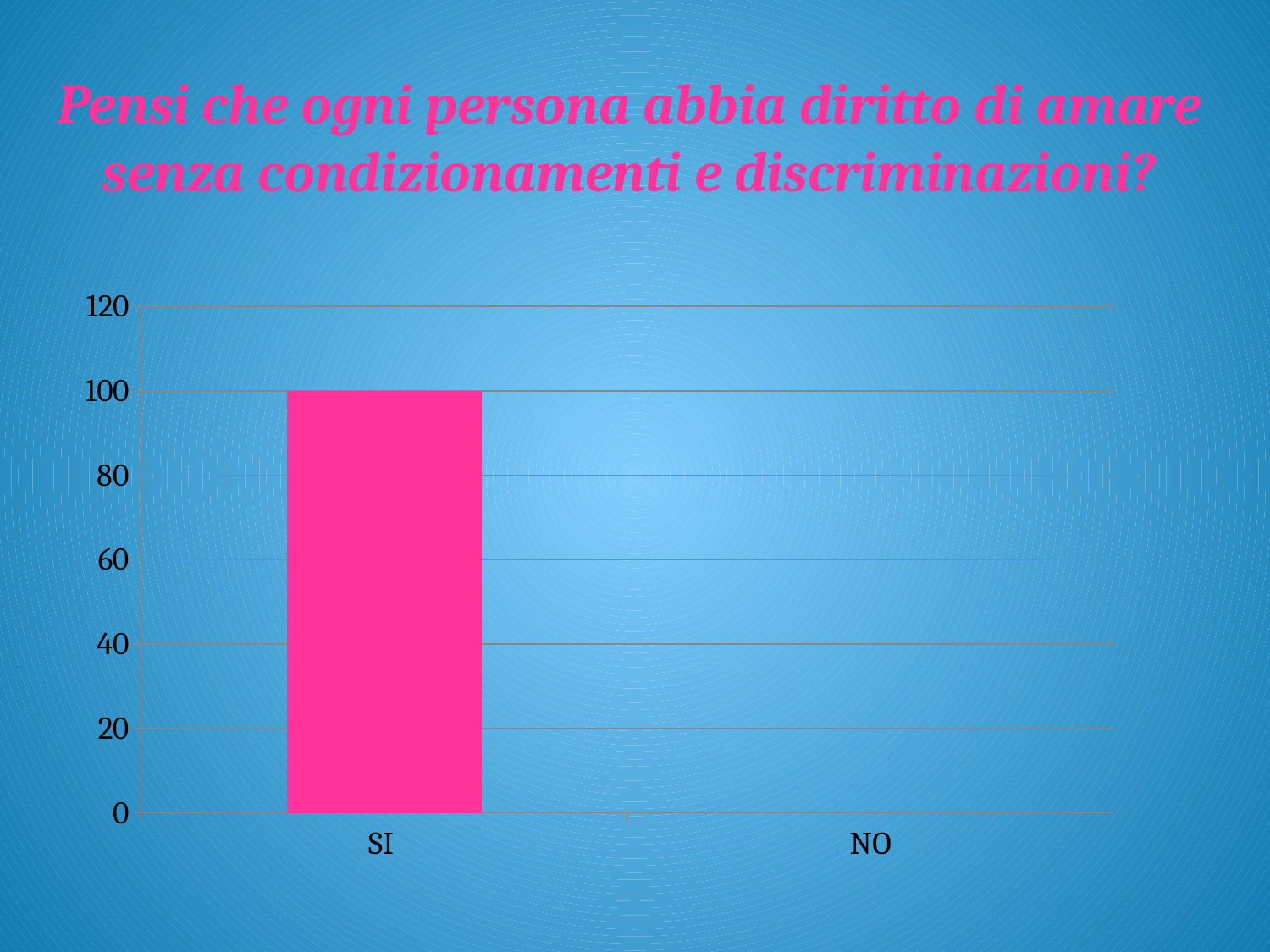
What is the highest tick value shown on the y axis of the chart? 120 What kind of chart is shown on the slide? bar chart How many categories are shown on the x axis of the chart? 2 Which category has the lowest value in the chart? NO What is the value for SI in the chart? 100 Is the value for SI greater or less than 80? greater Which is larger, the value for SI or the value for NO? SI What colour is the bar for SI in the chart? pink Is the value for SI greater or less than 120? less Which category has the highest value in the chart? SI